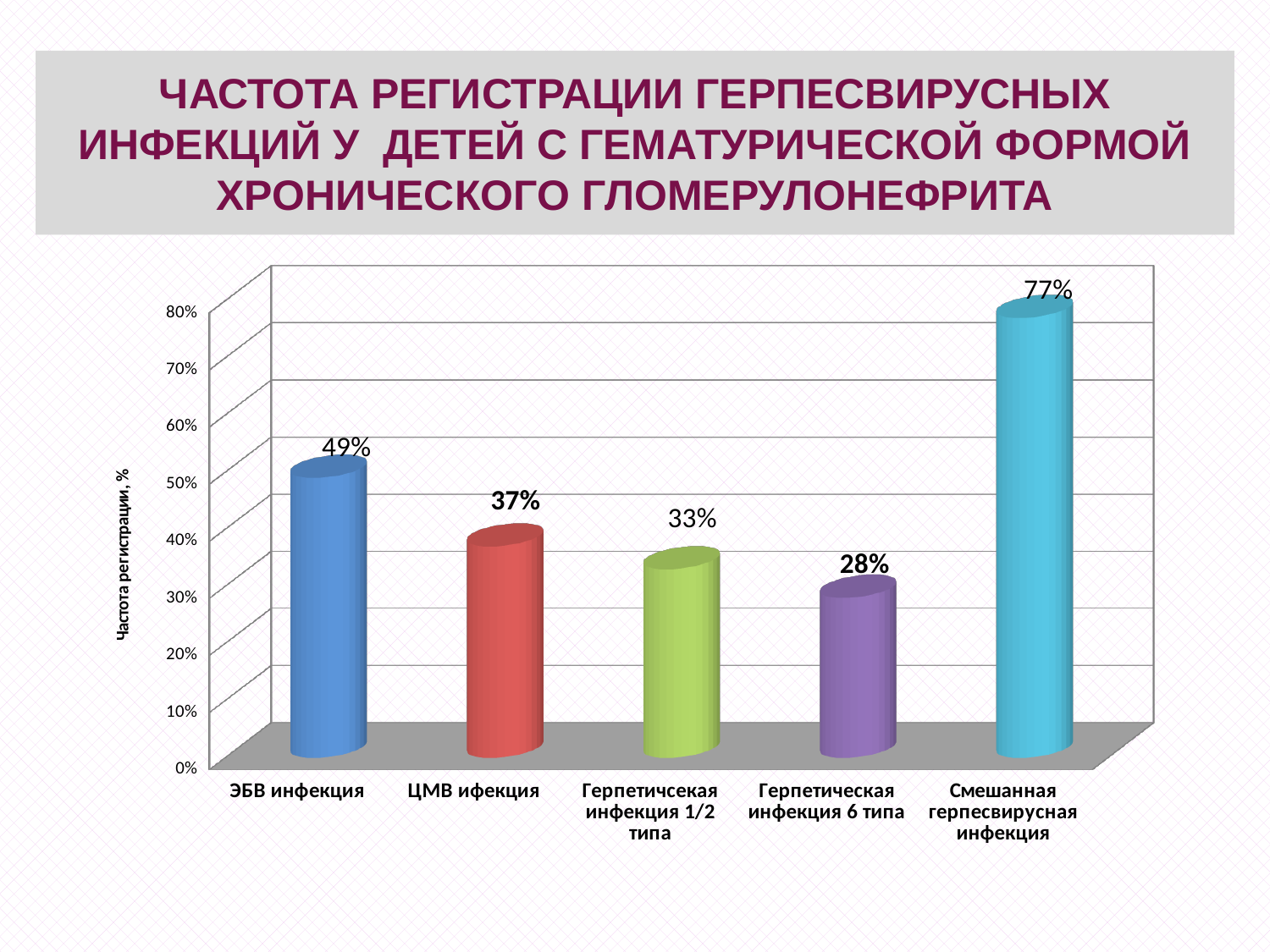
What is the value for ЦМВ ифекция? 37% What is the value for Герпетичсекая инфекция 1/2 типа? 33% What is the value for Герпетическая инфекция 6 типа? 28% What kind of chart is shown on the slide? Bar chart Which is larger, the value for ЦМВ ифекция or the value for Герпетичсекая инфекция 1/2 типа? ЦМВ ифекция Which category has the lowest value? Герпетическая инфекция 6 типа What is the difference between the values for Смешанная герпесвирусная инфекция and ЭБВ инфекция? 28% What is the value for Смешанная герпесвирусная инфекция? 77% What is the value for ЭБВ инфекция? 49% Which category has the highest value? Смешанная герпесвирусная инфекция What is the label of the vertical axis? Частота регистрации, % How many categories are shown in the chart? 5